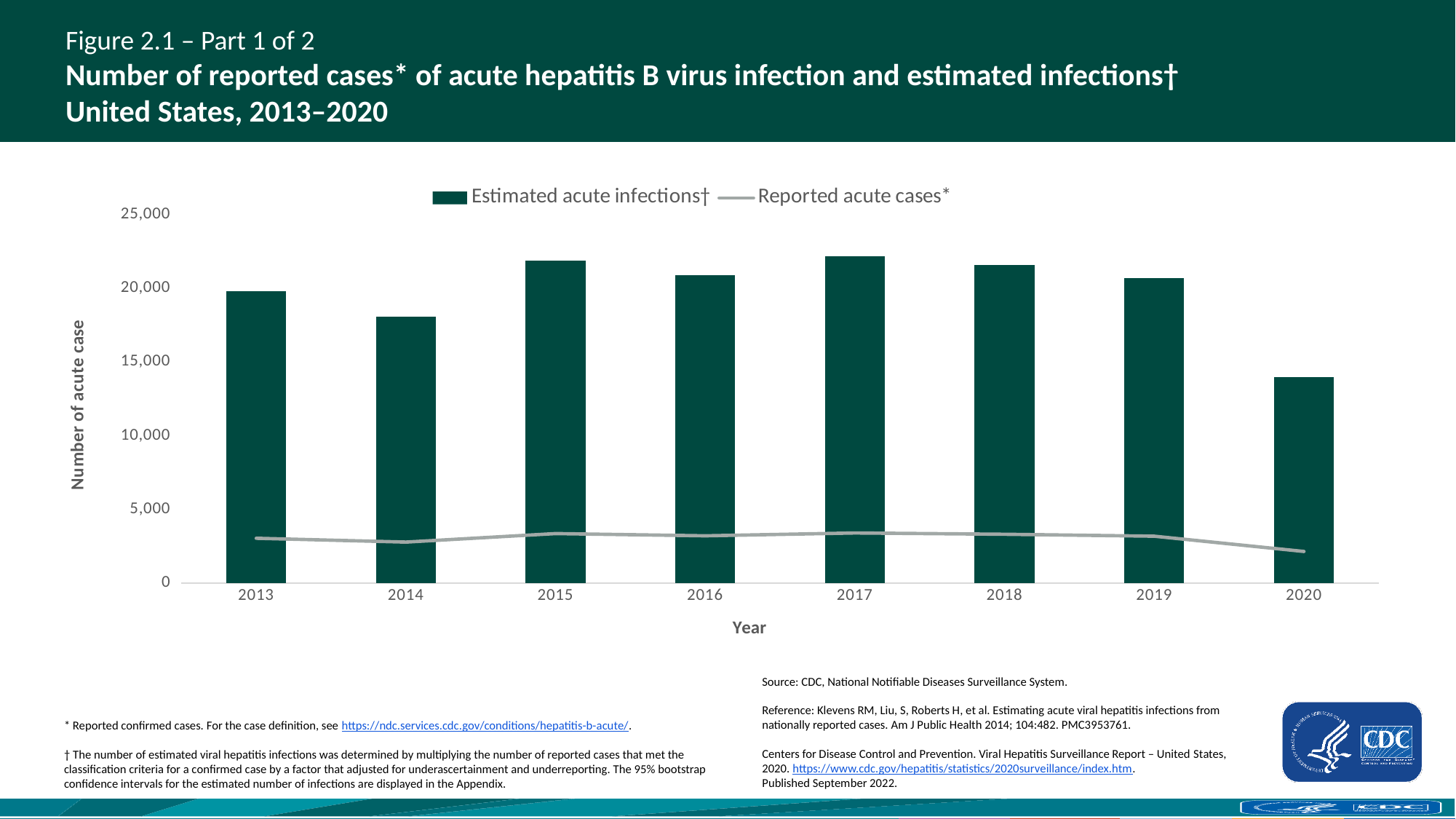
Is the value for estimated acute infections in 2014 greater or less than 20,000? less Is the value for estimated acute infections in 2017 greater or less than 20,000? greater What kind of chart is used to show the estimated acute infections? bar chart How many series does the legend list? 2 Which year has more estimated acute infections, 2014 or 2015? 2015 Which year has the lowest number of estimated acute infections? 2020 Is the value for reported acute cases in 2013 greater or less than 5,000? less Do the estimated acute infections rise or fall from 2019 to 2020? fall What is the title of the y axis? Number of acute case Which year has more estimated acute infections, 2019 or 2020? 2019 How many years are shown on the x axis? 8